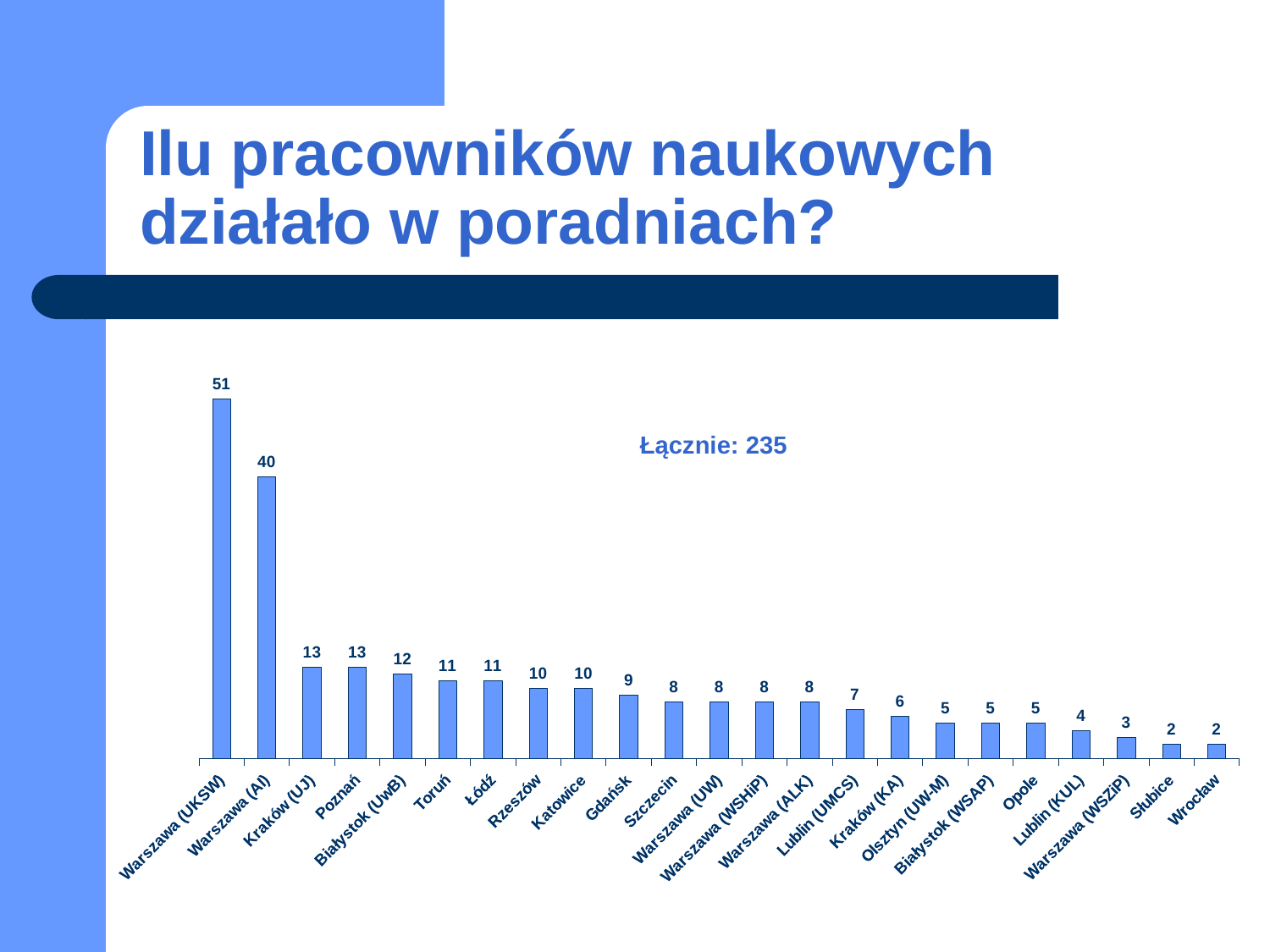
What is the difference between the values for Warszawa (UKSW) and Warszawa (AI)? 11 What is the value for Lublin (UMCS)? 7 What is the value shown for Białystok (UwB)? 12 What is the value for Lublin (KUL)? 4 What is the lowest value shown in the chart? 2 What total is stated in the text label on the chart? Łącznie: 235 How many categories are plotted in the chart? 23 Which category has the highest value? Warszawa (UKSW) What type of chart is shown on the slide? bar chart What is the value for Warszawa (AI)? 40 Which is larger, the value for Gdańsk or the value for Kraków (KA)? Gdańsk How many scientific staff are shown for Warszawa (UKSW)? 51